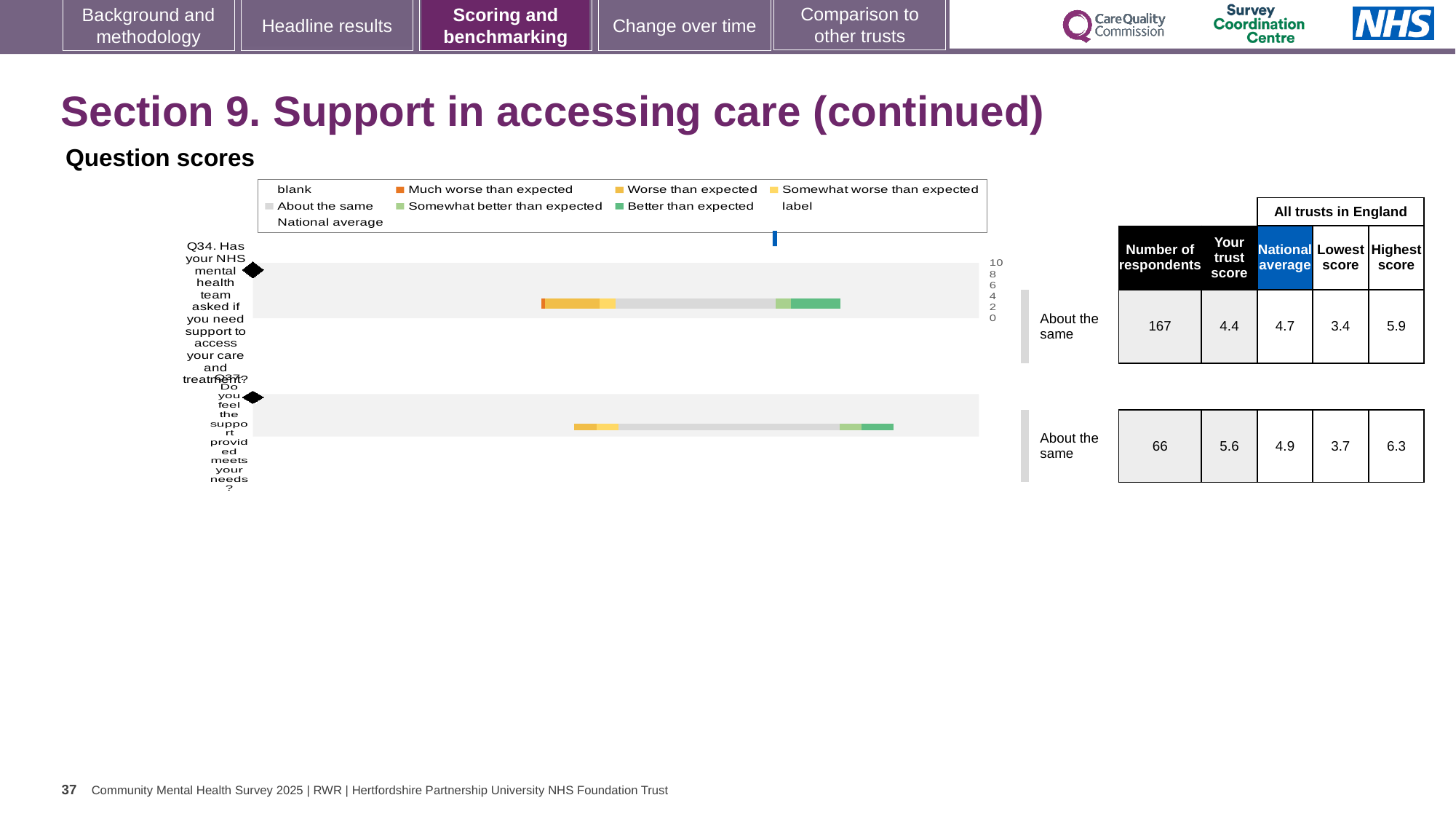
What is the national average for Q37 shown in the table beside the chart? 4.9 Which benchmarking category is Q34 placed in, according to the label next to its bar? About the same What kind of chart is used to show the question scores on this slide? bar chart How many respondents answered Q34, according to the table beside the chart? 167 What is the trust score for Q37 shown in the table beside the chart? 5.6 How many questions are plotted in the question scores chart? 2 What is the difference between the trust score and the national average for Q37? 0.7 Which question has the higher trust score, Q34 or Q37? Q37 What is the highest score across all trusts in England for Q37? 6.3 For Q37, is the trust score or the national average larger? trust score What is the trust score for Q34 shown in the table beside the chart? 4.4 Which benchmarking category is Q37 placed in, according to the label next to its bar? About the same